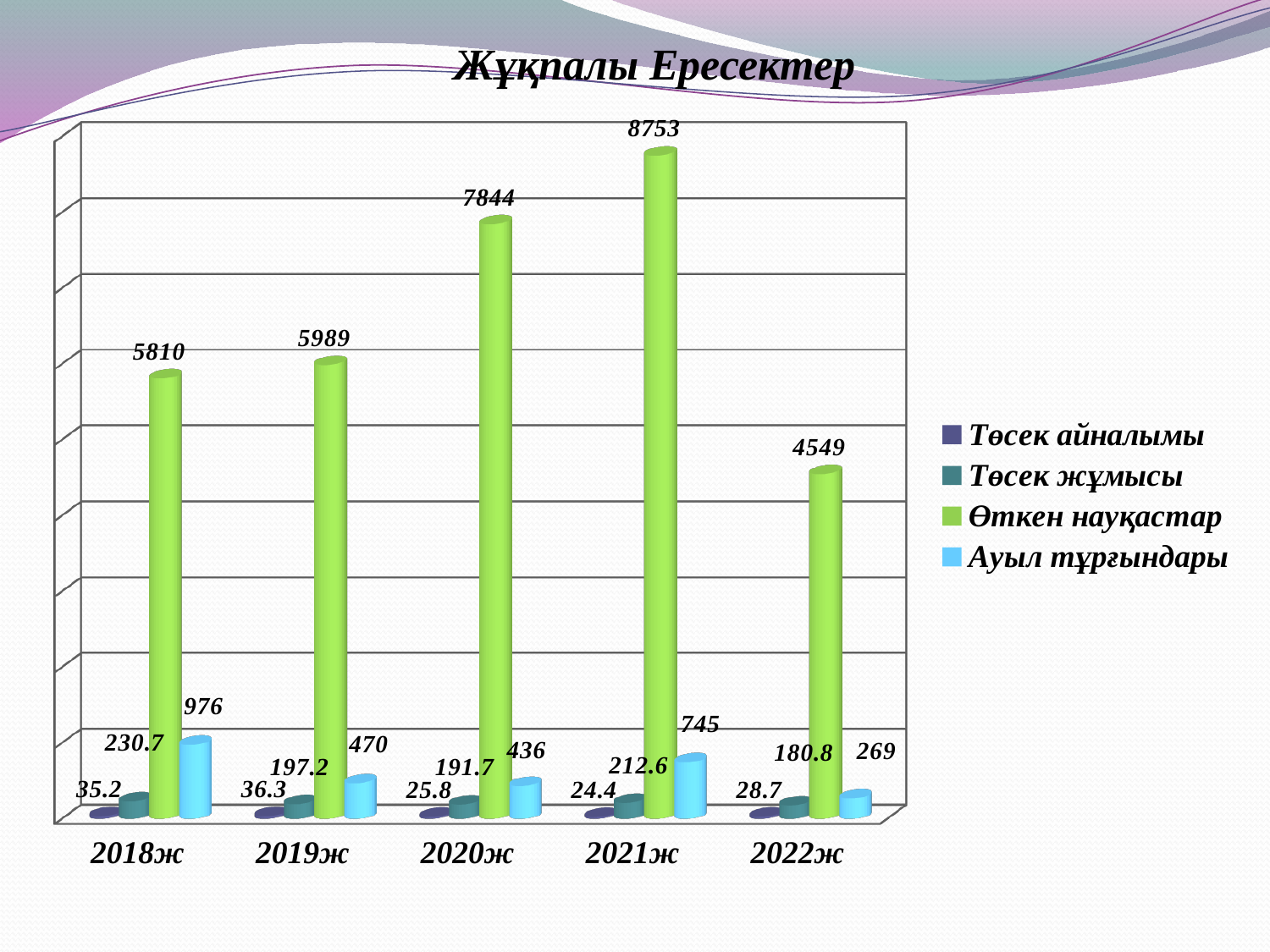
In which year is Ауыл тұрғындары lowest? 2022ж What is the title of the chart? Жұқпалы Ересектер What is the value of Төсек жұмысы for 2020ж? 191.7 What is the value of Төсек айналымы for 2022ж? 28.7 How many years are shown on the x axis? 5 What kind of chart is shown on the slide? Bar chart What is the difference between Өткен науқастар in 2021ж and 2022ж? 4204 How many series does the legend list? 4 In which year is Өткен науқастар highest? 2021ж What is the value of Өткен науқастар for 2021ж? 8753 Which is larger: Ауыл тұрғындары in 2019ж or in 2021ж? 2021ж What is the value of Ауыл тұрғындары for 2018ж? 976